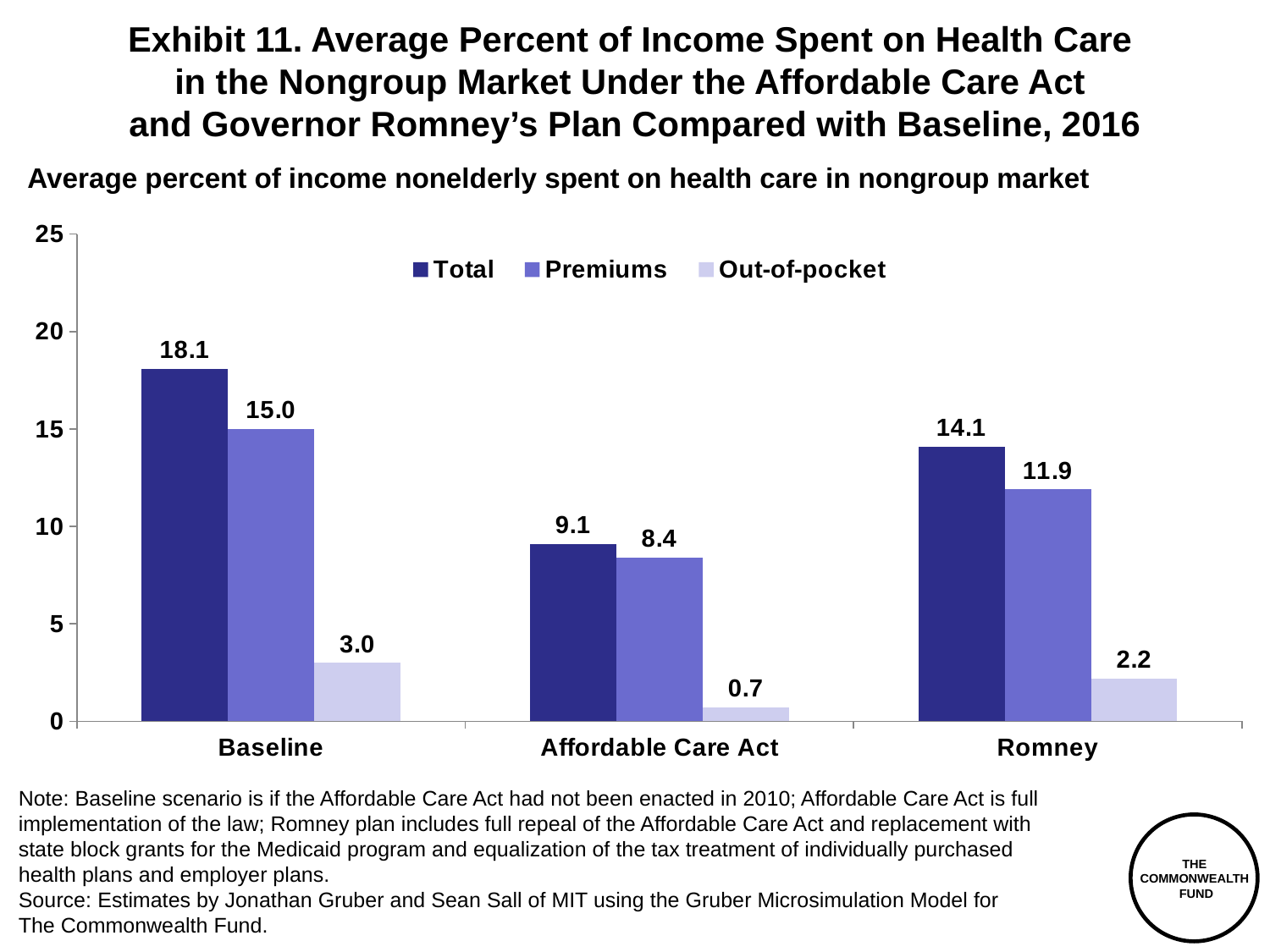
How many scenarios are shown on the x axis? 3 Which scenario has the highest Total value? Baseline What kind of chart is shown on the slide? bar chart What is the Total value for Baseline? 18.1 How many series does the legend list? 3 Which is larger, the Premiums value for Romney or the Premiums value for the Affordable Care Act? Romney What is the difference between the Premiums and Out-of-pocket values for Baseline? 12.0 What is the Premiums value for the Affordable Care Act? 8.4 What is the Out-of-pocket value for Romney? 2.2 What is the difference between the Total values for Baseline and the Affordable Care Act? 9.0 Which scenario has the lowest Out-of-pocket value? Affordable Care Act Is the Total value for Romney greater or less than 15? less